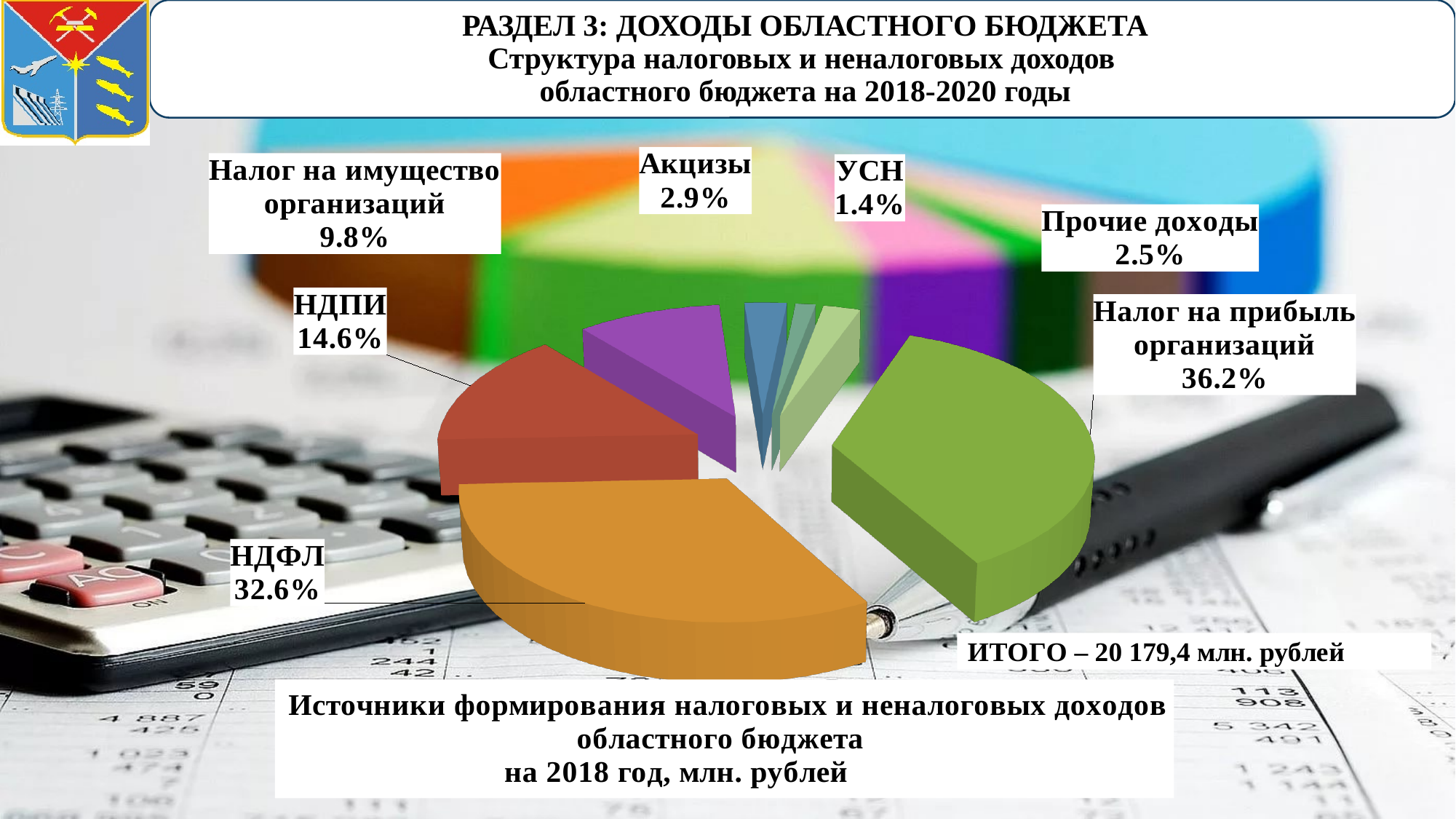
What share of the pie does Налог на прибыль организаций have? 36.2% How many slices does the pie chart have? 7 Which category has the smallest share of the pie? УСН What share of the pie does НДФЛ have? 32.6% What is the value shown for НДПИ? 14.6% What is the value shown for УСН? 1.4% What is the value shown for Прочие доходы? 2.5% Which category has the largest share of the pie? Налог на прибыль организаций What is the value shown for Акцизы? 2.9% What kind of chart is shown on the slide? pie chart What is the difference in percentage points between Налог на прибыль организаций and НДФЛ? 3.6 What is the value shown for Налог на имущество организаций? 9.8%